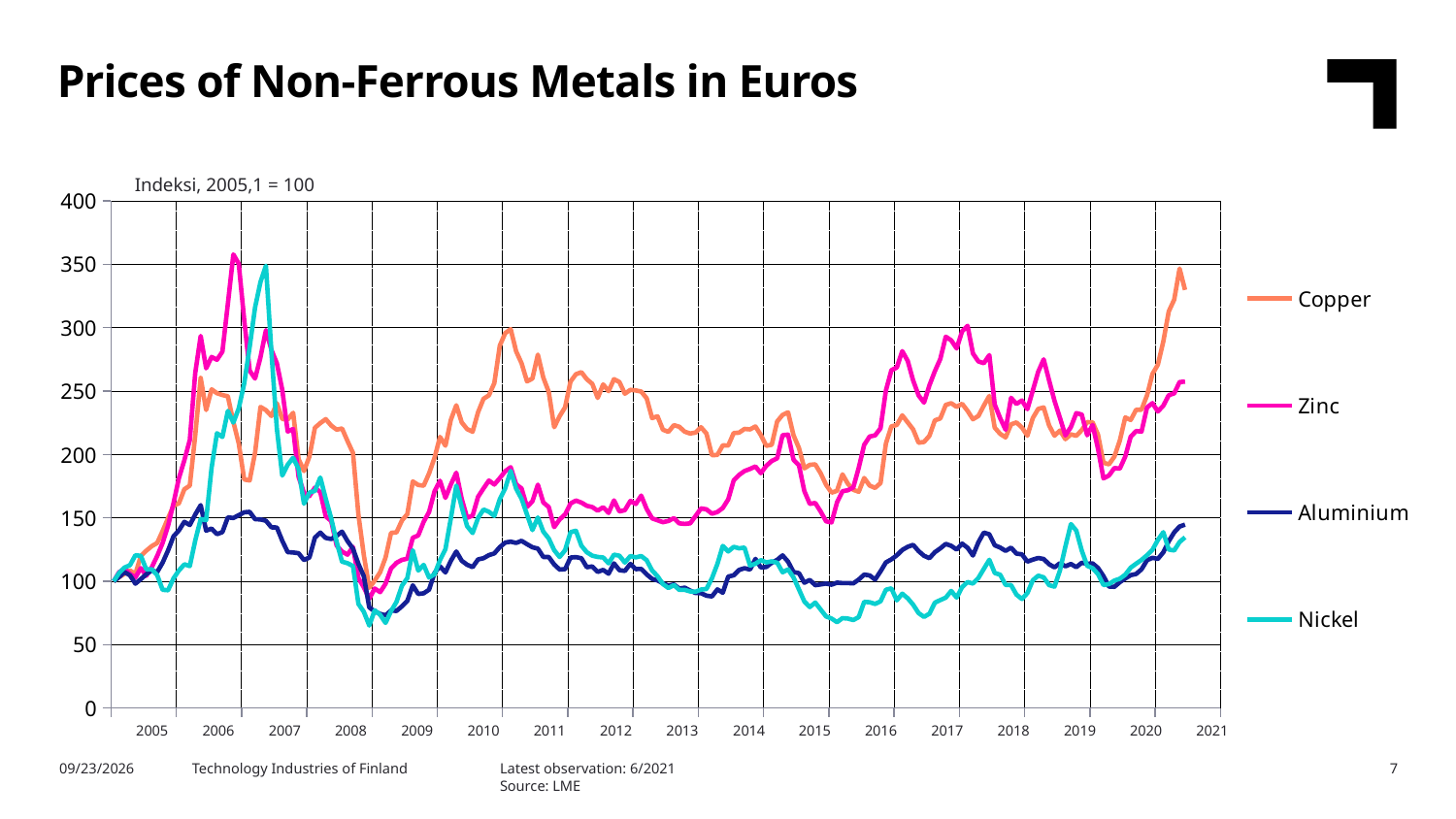
Does the Copper series rise or fall from 2019 to 2021? rise Which series is drawn in dark blue in the legend? Aluminium What kind of chart is shown on the slide? line chart Which series has the lowest value around 2015? Nickel Is the highest value reached by Aluminium greater or less than 200? less What is the title of the chart? Prices of Non-Ferrous Metals in Euros Which is larger in 2013, the value for Copper or the value for Aluminium? Copper Which series has the highest value at the end of the chart in 2021? Copper Is the peak value for Zinc in 2017 greater or less than 250? greater How many series does the legend list? 4 Is the value for Copper at the end of the chart in 2021 greater or less than 300? greater